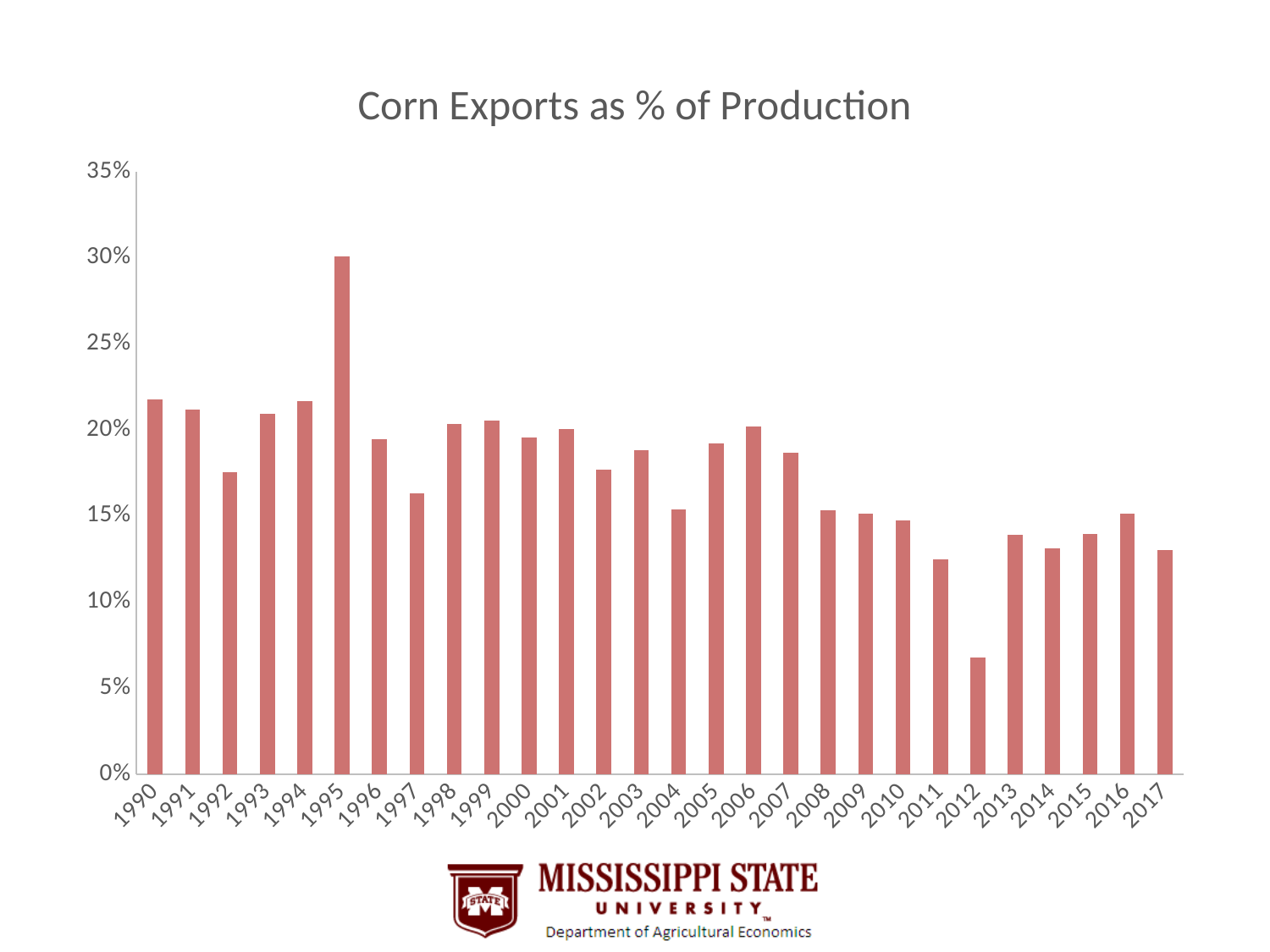
Which year has the larger value, 1990 or 2017? 1990 How many years are plotted on the chart? 28 Which year has the lowest corn exports as a percentage of production? 2012 What kind of chart is shown on the slide? Bar chart Which year has the highest corn exports as a percentage of production? 1995 Is the value for 1990 greater or less than 20%? greater Is the value for 2012 greater or less than 10%? less Overall, do corn exports as a percentage of production rise or fall from 1990 to 2017? Fall What is the title of the chart? Corn Exports as % of Production Which year has the larger value, 2012 or 2013? 2013 Is the value for 2014 greater or less than 15%? less